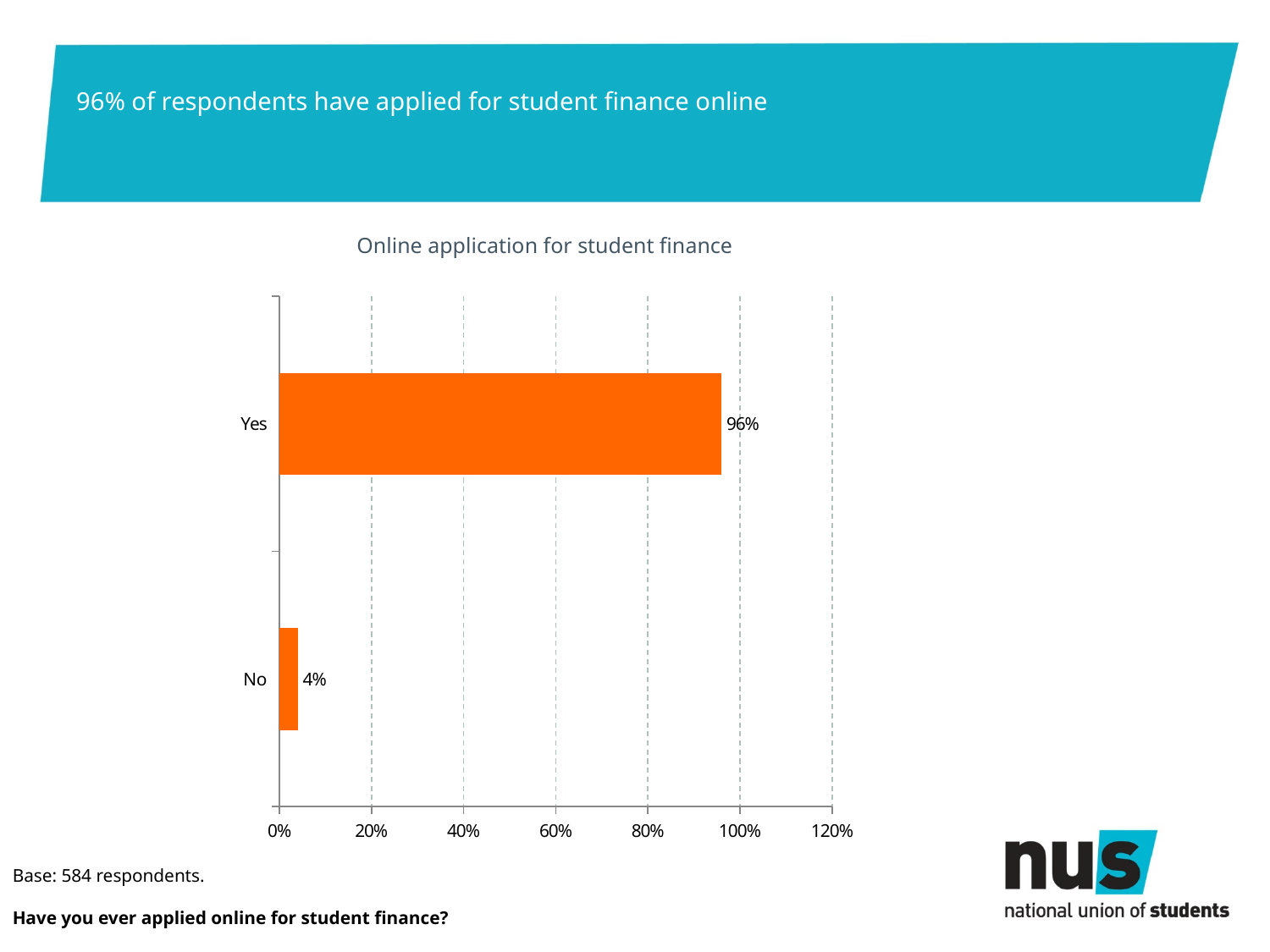
What is the highest value shown on the x axis? 120% Which category has the lowest value? No How many categories are shown in the chart? 2 What is the difference between the values for Yes and No? 92% What is the value for Yes? 96% What kind of chart is shown on the slide? Bar chart Which is larger, the value for Yes or the value for No? Yes What is the value for No? 4% Is the value for Yes greater or less than 80%? greater Which category has the highest value? Yes What is the title of the chart? Online application for student finance Is the value for No greater or less than 20%? less